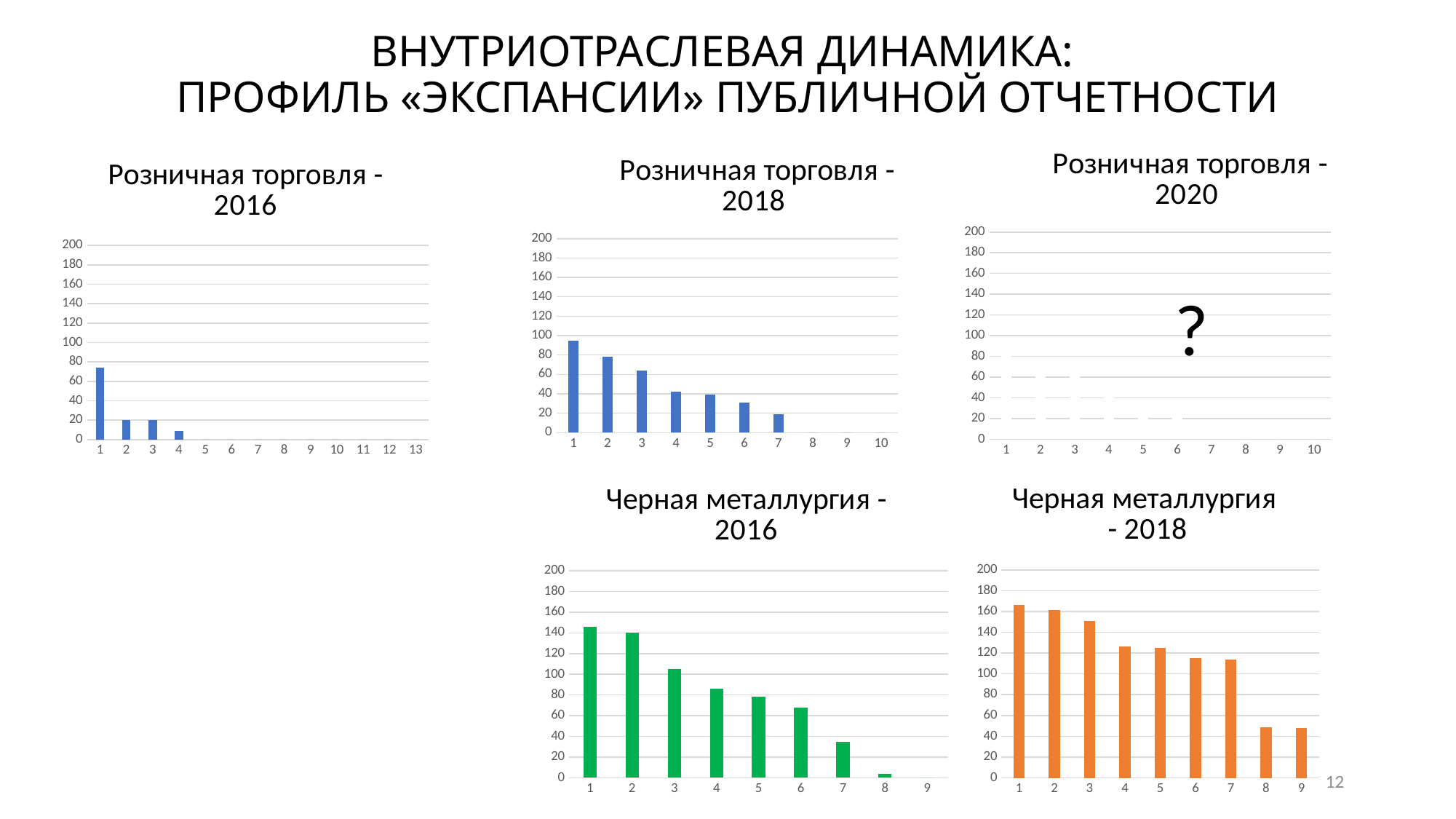
In the "Черная металлургия - 2016" chart, is the value for category 3 greater or less than 100? greater In the "Черная металлургия - 2018" chart, is the value for category 8 greater or less than 60? less In the "Черная металлургия - 2018" chart, do the values rise or fall from category 1 to category 9? fall In the "Черная металлургия - 2018" chart, is the value for category 1 greater or less than 160? greater What is shown in place of data in the "Розничная торговля - 2020" chart? a question mark In the "Черная металлургия - 2016" chart, which category has the highest value? 1 How many bars are plotted in the "Черная металлургия - 2018" chart? 9 What kind of chart is "Черная металлургия - 2016"? bar chart In the "Розничная торговля - 2016" chart, which is larger, the value for category 1 or the value for category 4? category 1